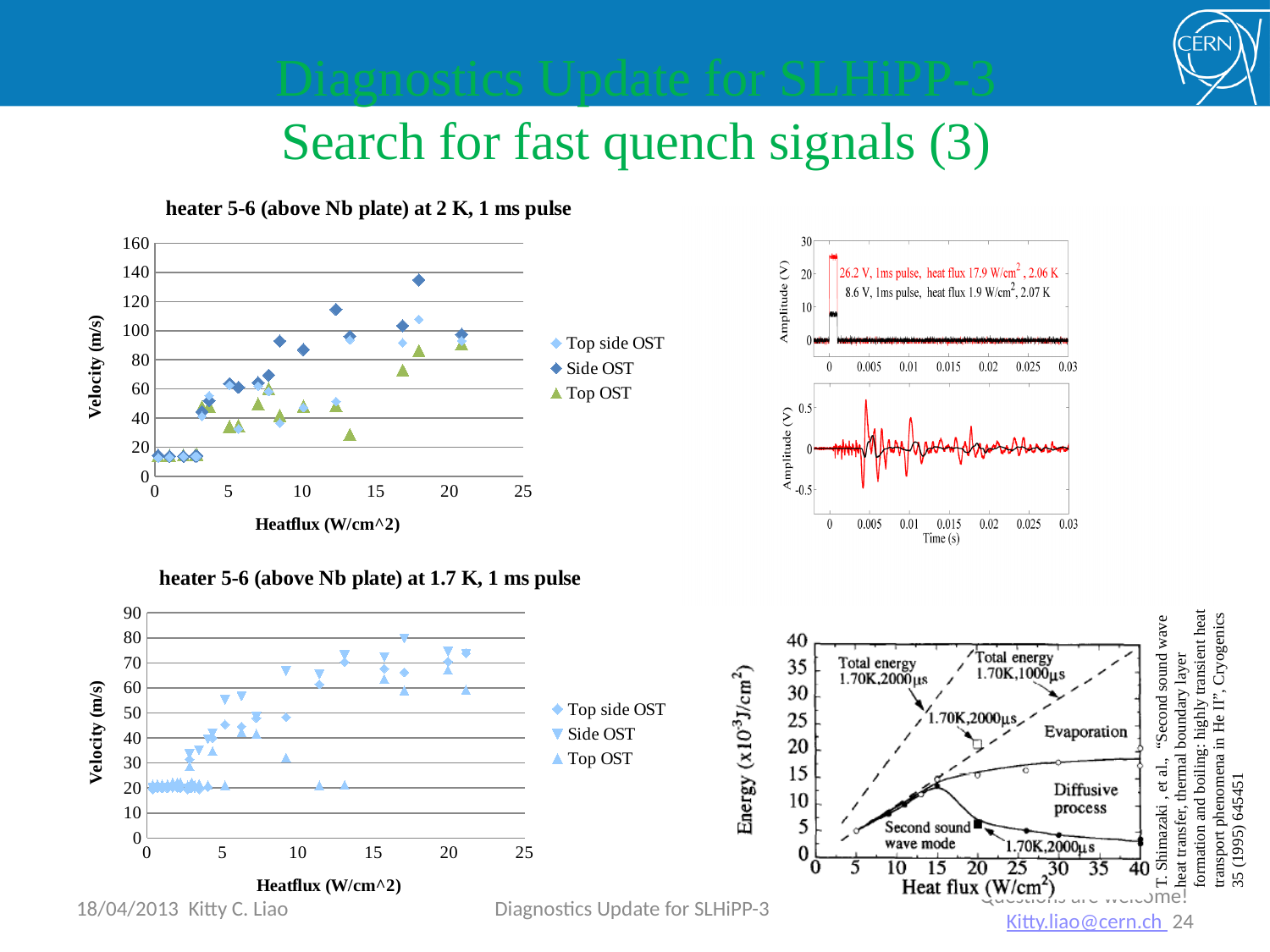
In the chart titled 'heater 5-6 (above Nb plate) at 1.7 K, 1 ms pulse', is the highest Side OST velocity greater or less than 70 m/s? greater In the oscilloscope trace plot at the top right, what heat flux is stated for the 26.2 V, 1 ms pulse? 17.9 W/cm2 In the chart titled 'heater 5-6 (above Nb plate) at 2 K, 1 ms pulse', which series reaches the highest velocity? Side OST In the chart titled 'heater 5-6 (above Nb plate) at 2 K, 1 ms pulse', is the highest Side OST velocity greater or less than 120 m/s? greater What kind of chart is the one titled 'heater 5-6 (above Nb plate) at 2 K, 1 ms pulse'? scatter chart In the chart titled 'heater 5-6 (above Nb plate) at 1.7 K, 1 ms pulse', what is the maximum value shown on the vertical axis? 90 In the chart titled 'heater 5-6 (above Nb plate) at 2 K, 1 ms pulse', do the velocities generally rise or fall as heat flux increases? rise What is the x-axis label of the chart titled 'heater 5-6 (above Nb plate) at 2 K, 1 ms pulse'? Heatflux (W/cm^2) In the chart titled 'heater 5-6 (above Nb plate) at 1.7 K, 1 ms pulse', are the Top OST velocities at heat fluxes below 5 W/cm^2 greater or less than 40 m/s? less In the chart titled 'heater 5-6 (above Nb plate) at 1.7 K, 1 ms pulse', which series has the lowest velocities at high heat flux (above 10 W/cm^2)? Top OST In the oscilloscope trace plot at the top right, what temperature is stated for the 8.6 V, 1 ms pulse? 2.07 K In the chart titled 'heater 5-6 (above Nb plate) at 2 K, 1 ms pulse', how many series does the legend list? 3